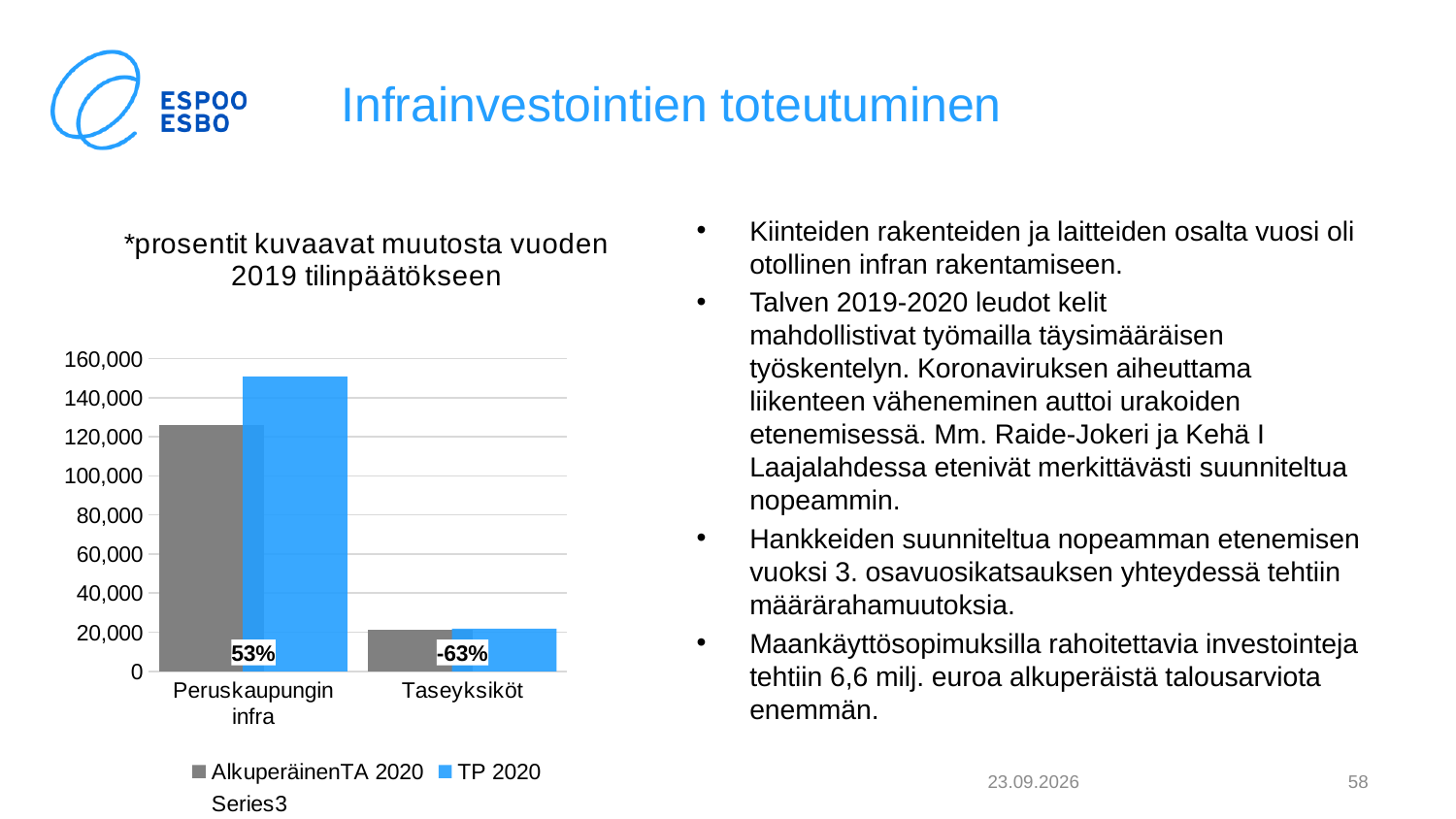
What percentage label is printed on the Peruskaupungin infra bars? 53% How many series does the chart's legend list? 3 Which category has the highest TP 2020 value? Peruskaupungin infra What kind of chart is shown on the slide? bar chart Is the TP 2020 value for Peruskaupungin infra greater or less than 140,000? greater How many categories are shown on the x axis of the chart? 2 What percentage label is printed on the Taseyksiköt bars? -63% Is the TP 2020 value for Taseyksiköt greater or less than 40,000? less What is the text shown above the chart? *prosentit kuvaavat muutosta vuoden 2019 tilinpäätökseen For Peruskaupungin infra, which is larger: AlkuperäinenTA 2020 or TP 2020? TP 2020 Is the AlkuperäinenTA 2020 value for Peruskaupungin infra greater or less than 100,000? greater What colour are the TP 2020 bars in the chart? blue